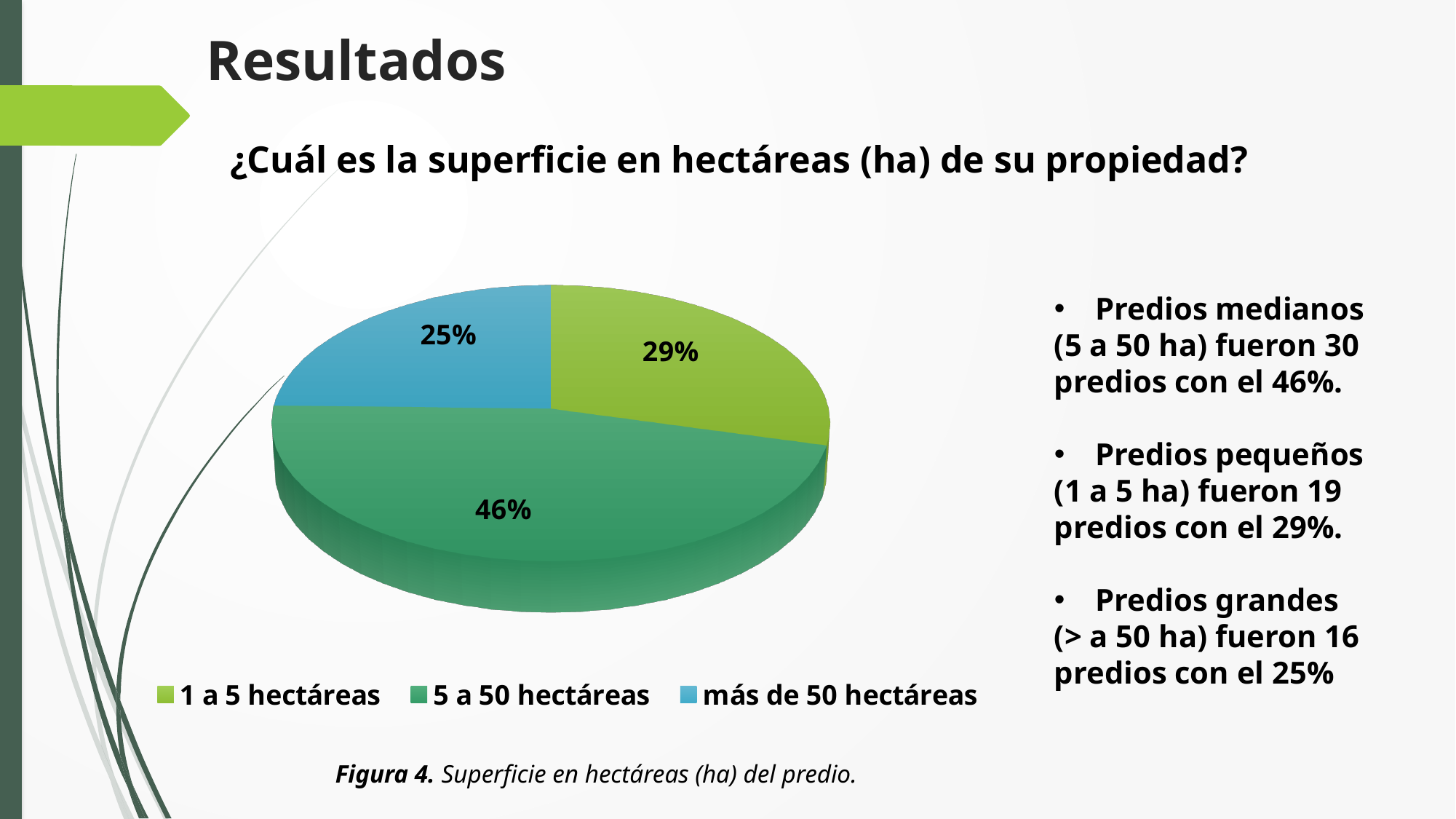
What is the figure caption below the chart? Figura 4. Superficie en hectáreas (ha) del predio. What is the difference in percentage points between the '5 a 50 hectáreas' slice and the '1 a 5 hectáreas' slice? 17 What share of the pie does the '5 a 50 hectáreas' slice represent? 46% How many categories does the pie chart have? 3 Which category has the largest slice of the pie? 5 a 50 hectáreas What share of the pie does the 'más de 50 hectáreas' slice represent? 25% Which category has the smallest slice of the pie? más de 50 hectáreas What share of the pie does the '1 a 5 hectáreas' slice represent? 29% What is the difference in percentage points between the '1 a 5 hectáreas' slice and the 'más de 50 hectáreas' slice? 4 What kind of chart is shown on the slide? Pie chart Which is larger: the '1 a 5 hectáreas' slice or the 'más de 50 hectáreas' slice? 1 a 5 hectáreas What colour is the '5 a 50 hectáreas' slice? Green